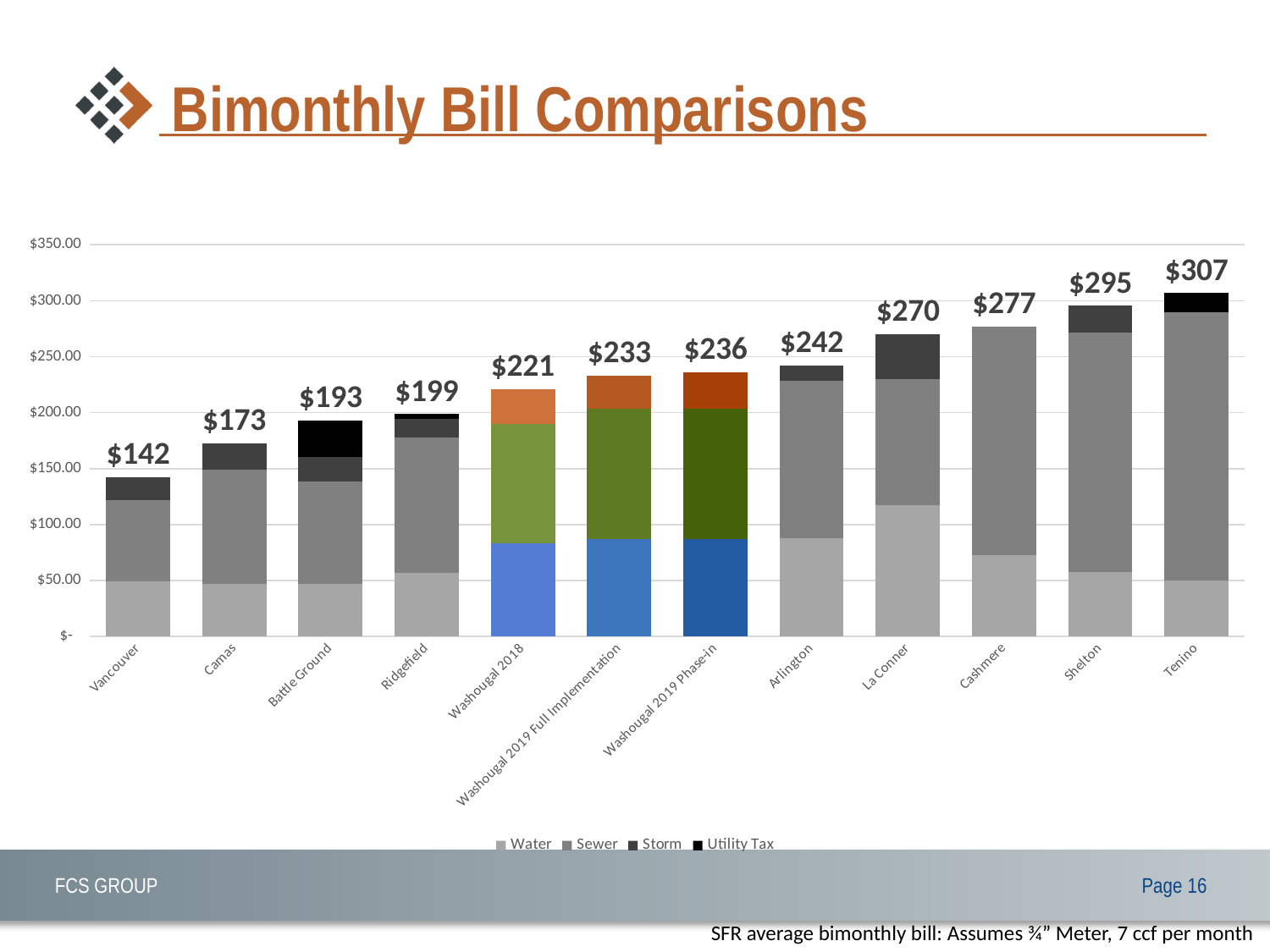
What is the total bimonthly bill shown for Vancouver? $142 Which has a larger total bill, Arlington or La Conner? La Conner How many cities or scenarios are shown on the x axis? 12 Do the total bills rise or fall moving from left to right along the x axis? Rise What kind of chart is shown on the slide? Stacked bar chart What is the difference between the total bills for Washougal 2019 Full Implementation and Washougal 2018? $12 How many series does the legend list? 4 Which city has the highest total bimonthly bill? Tenino What is the total bimonthly bill shown for Washougal 2019 Phase-in? $236 Is the Water portion of the La Conner bill greater or less than $100? greater Which city has the lowest total bimonthly bill? Vancouver What is the difference between the total bills for Tenino and Vancouver? $165